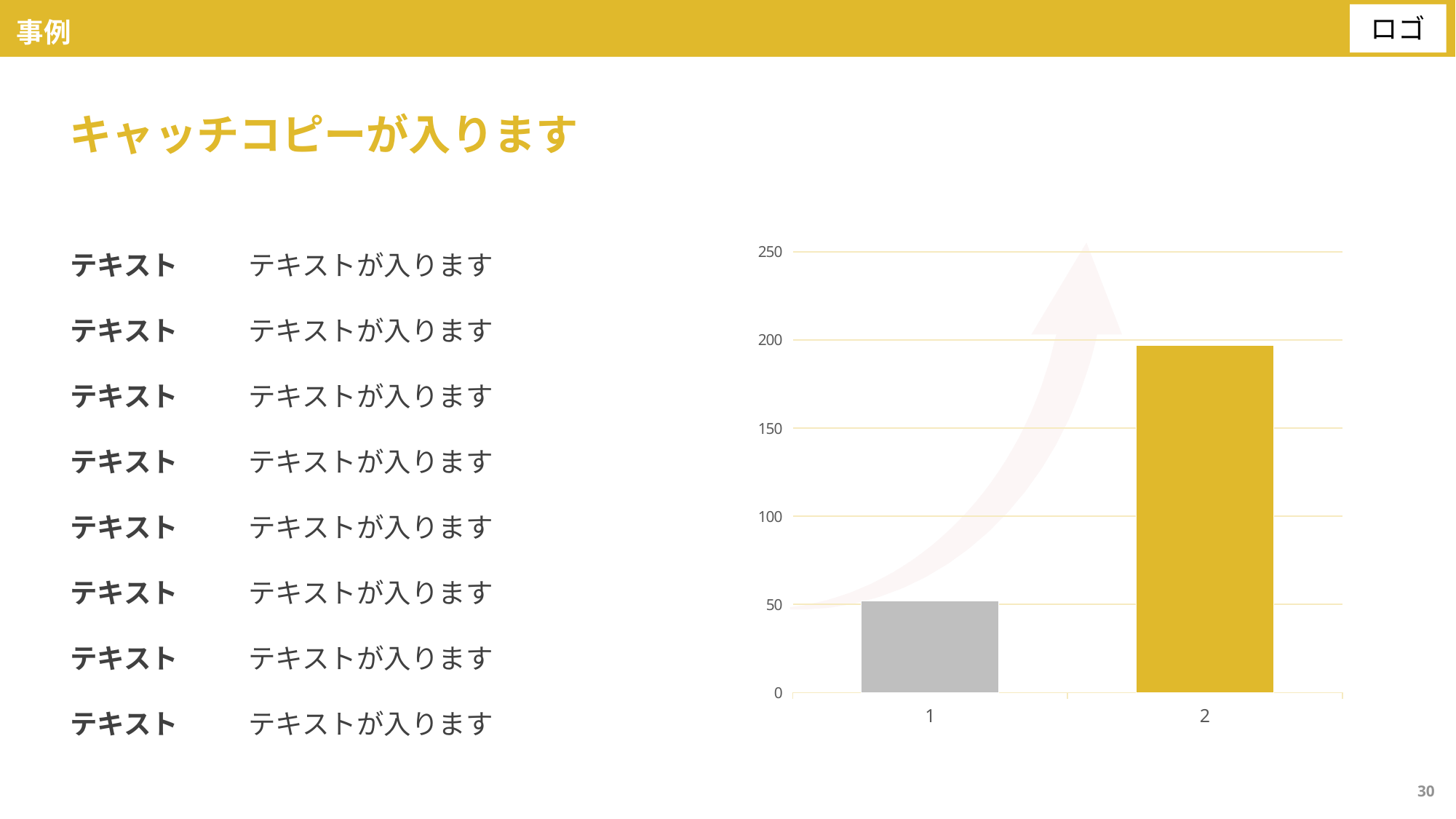
Which category has the lowest bar? 1 What kind of chart is shown on the slide? bar chart What is the highest value shown on the vertical axis? 250 Is the value for category 2 greater or less than 250? less Do the values rise or fall from category 1 to category 2? rise Which is larger, the value for category 1 or category 2? 2 How many bars (categories) does the chart show? 2 What colour is the bar for category 2? yellow Is the value for category 1 greater or less than 100? less Is the value for category 2 greater or less than 150? greater Which category has the highest bar? 2